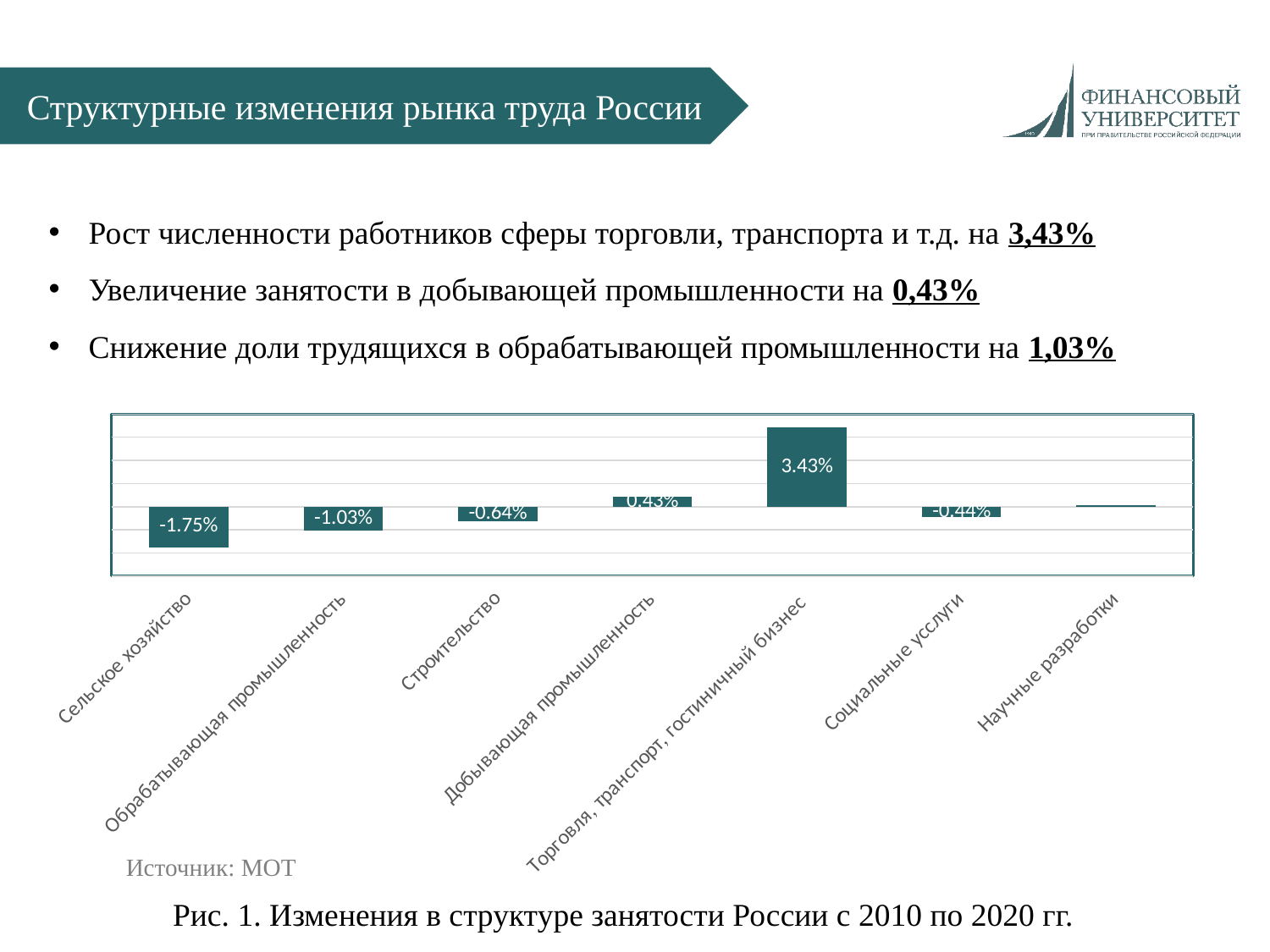
What is the value for Обрабатывающая промышленность? -1.03% What is the value for Социальные услуги? -0.44% What is the value for Добывающая промышленность? 0.43% What is the value for Сельское хозяйство? -1.75% Which category has the lowest value? Сельское хозяйство What is the value for Строительство? -0.64% How many categories are shown on the x axis of the chart? 7 What is the value for Торговля, транспорт, гостиничный бизнес? 3.43% Which is larger, the value for Добывающая промышленность or the value for Строительство? Добывающая промышленность Which category has the highest value? Торговля, транспорт, гостиничный бизнес What type of chart is shown on the slide? bar chart What is the caption given for the chart (Рис. 1)? Изменения в структуре занятости России с 2010 по 2020 гг.